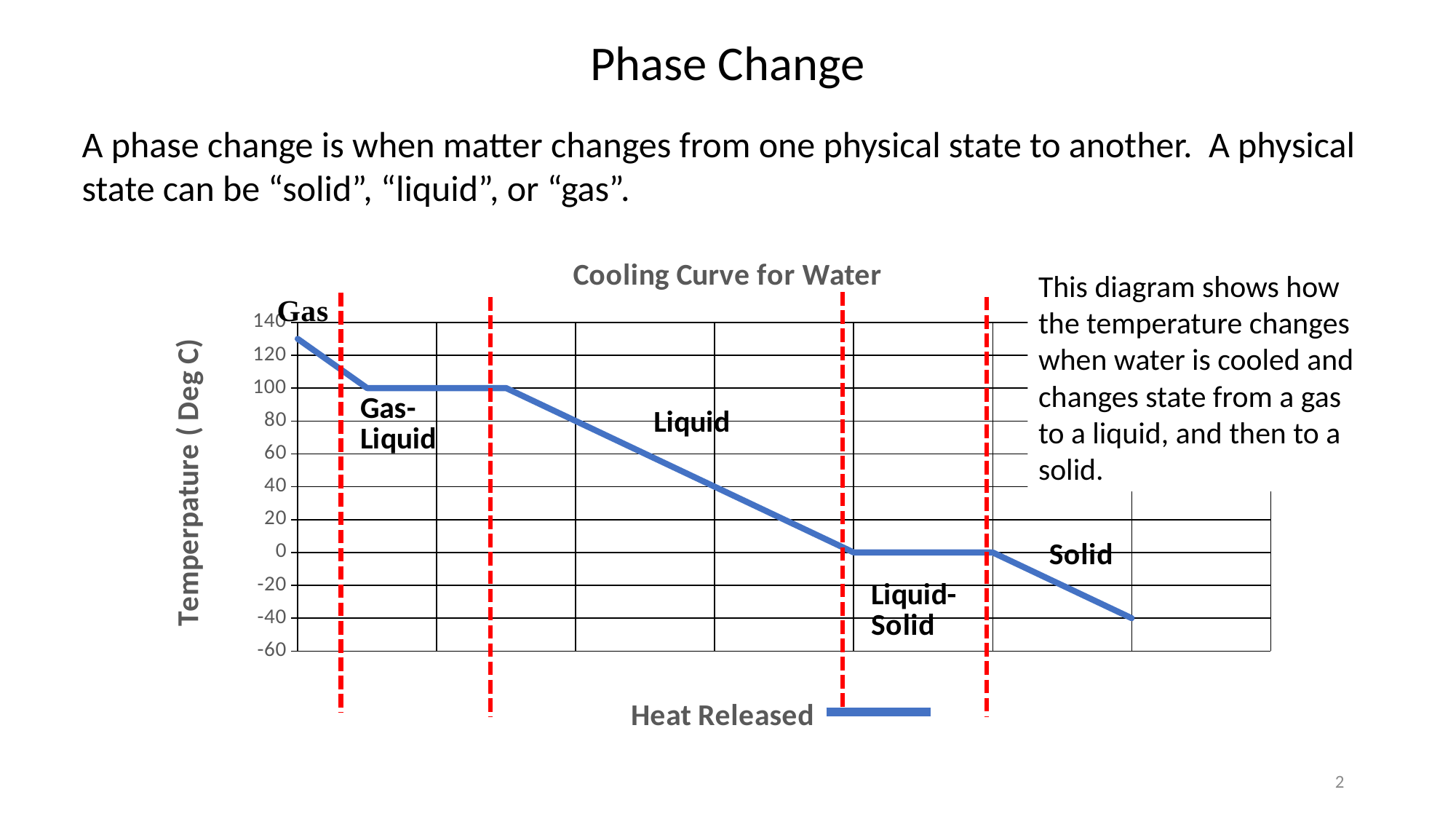
What is the final temperature reached at the end of the cooling curve? -40 How many phase regions are labelled on the cooling curve chart? 5 Which is higher on the cooling curve, the Gas-Liquid plateau or the Liquid-Solid plateau? Gas-Liquid plateau What is the difference in temperature between the Gas-Liquid plateau and the Liquid-Solid plateau? 100 What kind of chart is the Cooling Curve for Water? line chart Does the temperature rise or fall along the x axis of the Cooling Curve for Water? fall What is the title of the chart on the slide? Cooling Curve for Water Is the starting temperature of the cooling curve greater or less than 120? greater At what temperature does the Gas-Liquid plateau of the cooling curve occur? 100 At what temperature does the Liquid-Solid plateau of the cooling curve occur? 0